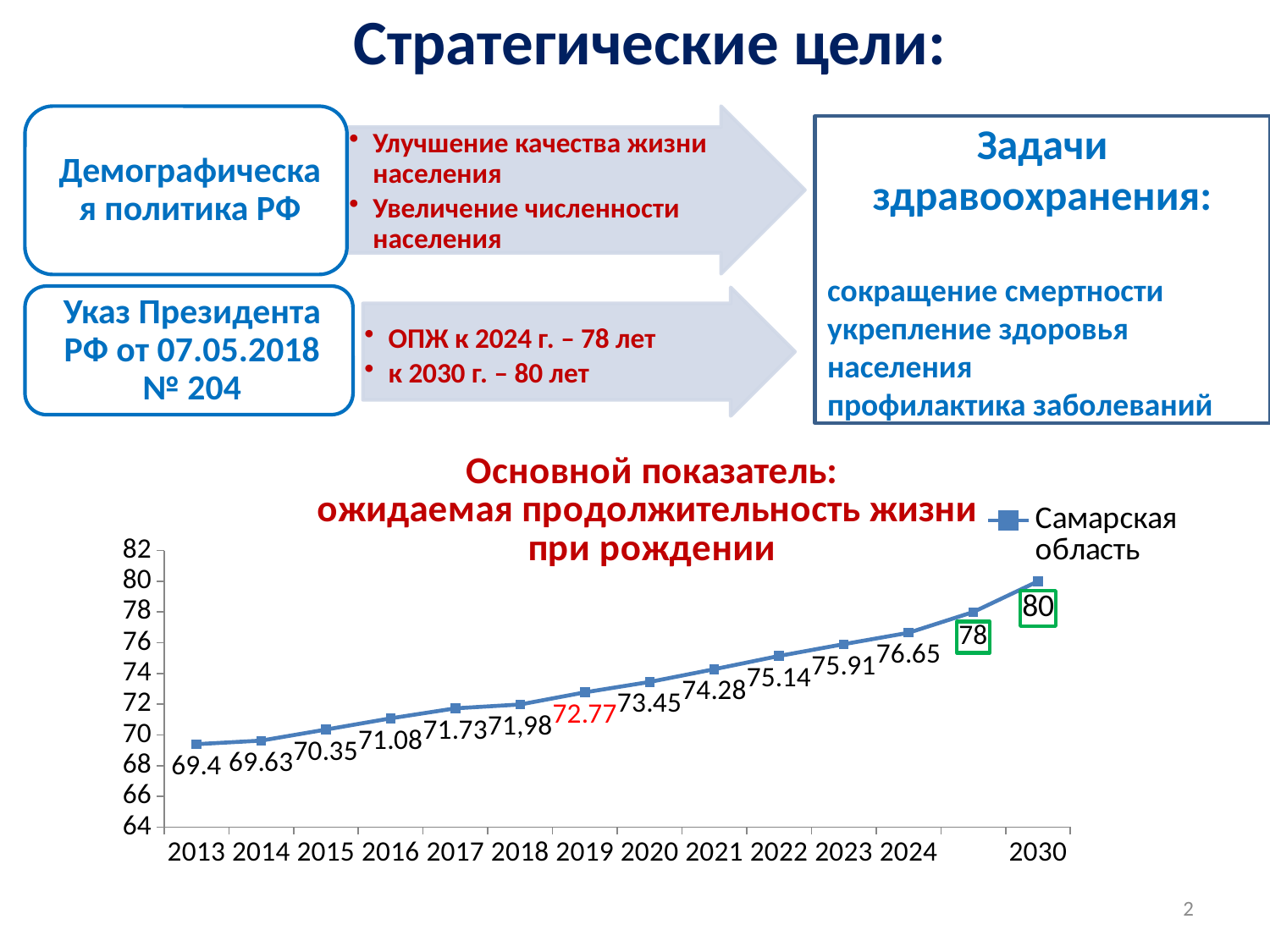
What is the expected life expectancy at birth for 2013 on the chart? 69.4 Do the values rise or fall from 2013 to 2030? rise Which year has the highest value on the chart? 2030 Which is larger, the value for 2021 or the value for 2018? 2021 Which year has the lowest value on the chart? 2013 What value is shown for 2024 on the chart? 76.65 What is the difference between the values for 2024 and 2023? 0.74 What type of chart is shown on the slide? line chart What is the difference between the values for 2030 and 2013? 10.6 What series name does the chart legend show? Самарская область What value is shown for 2030 on the chart? 80 What value is shown for 2019 on the chart? 72.77